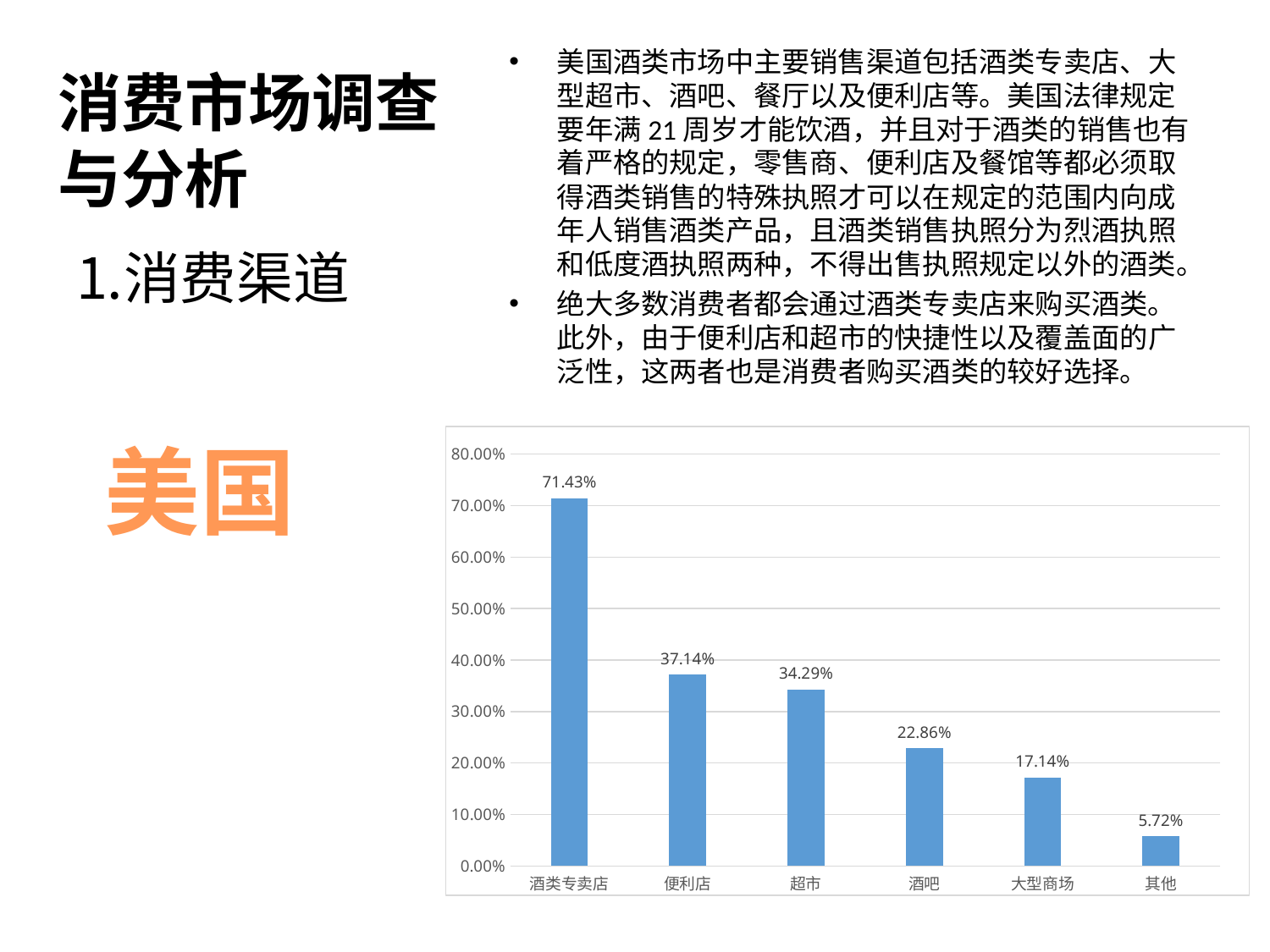
What is the value for 超市? 34.29% Which category has the highest value? 酒类专卖店 Which category has the lowest value? 其他 What is the value for 便利店? 37.14% What is the difference between the values for 酒类专卖店 and 便利店? 34.29% Is the value for 大型商场 greater or less than 20.00%? less What is the value for 酒吧? 22.86% Which is larger, the value for 酒吧 or the value for 大型商场? 酒吧 What kind of chart is shown on the slide? bar chart What is the value for 其他? 5.72% What is the value for 酒类专卖店? 71.43% How many categories are shown on the x axis? 6